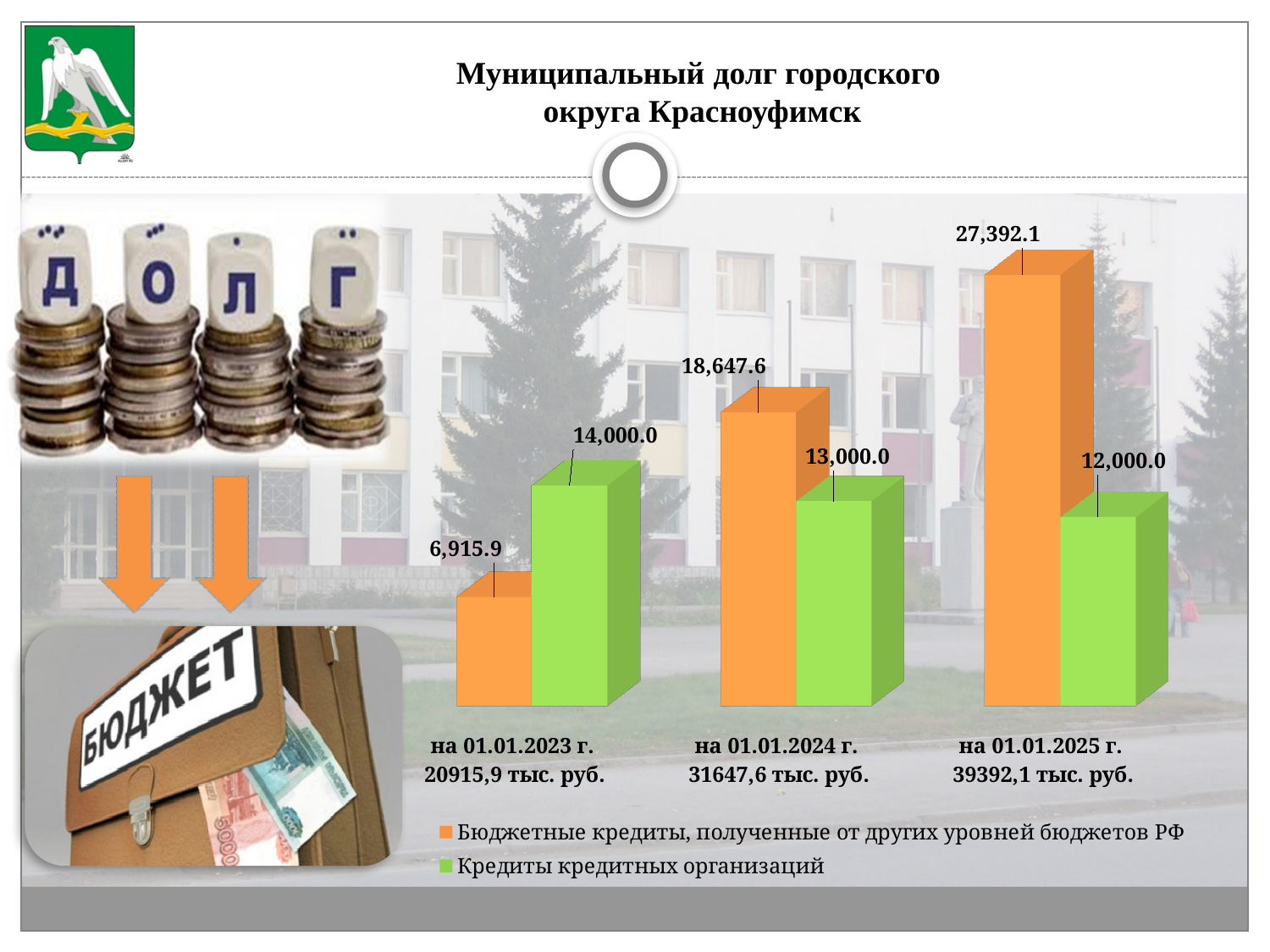
On which date is the value of 'Кредиты кредитных организаций' the lowest? на 01.01.2025 г. На 01.01.2023 г., which series has the larger value: 'Бюджетные кредиты, полученные от других уровней бюджетов РФ' or 'Кредиты кредитных организаций'? Кредиты кредитных организаций What is the value of 'Кредиты кредитных организаций' на 01.01.2023 г.? 14,000.0 How many dates (categories) are shown on the x axis of the chart? 3 Does the value of 'Кредиты кредитных организаций' rise or fall from 01.01.2023 to 01.01.2025? Fall On which date is the value of 'Бюджетные кредиты, полученные от других уровней бюджетов РФ' the highest? на 01.01.2025 г. What is the value of 'Кредиты кредитных организаций' на 01.01.2024 г.? 13,000.0 What is the value of 'Бюджетные кредиты, полученные от других уровней бюджетов РФ' на 01.01.2023 г.? 6,915.9 What kind of chart is shown on the slide? Bar chart What is the difference between 'Бюджетные кредиты, полученные от других уровней бюджетов РФ' на 01.01.2025 г. and на 01.01.2024 г.? 8,744.5 How many series does the chart legend list? 2 What is the value of 'Бюджетные кредиты, полученные от других уровней бюджетов РФ' на 01.01.2025 г.? 27,392.1